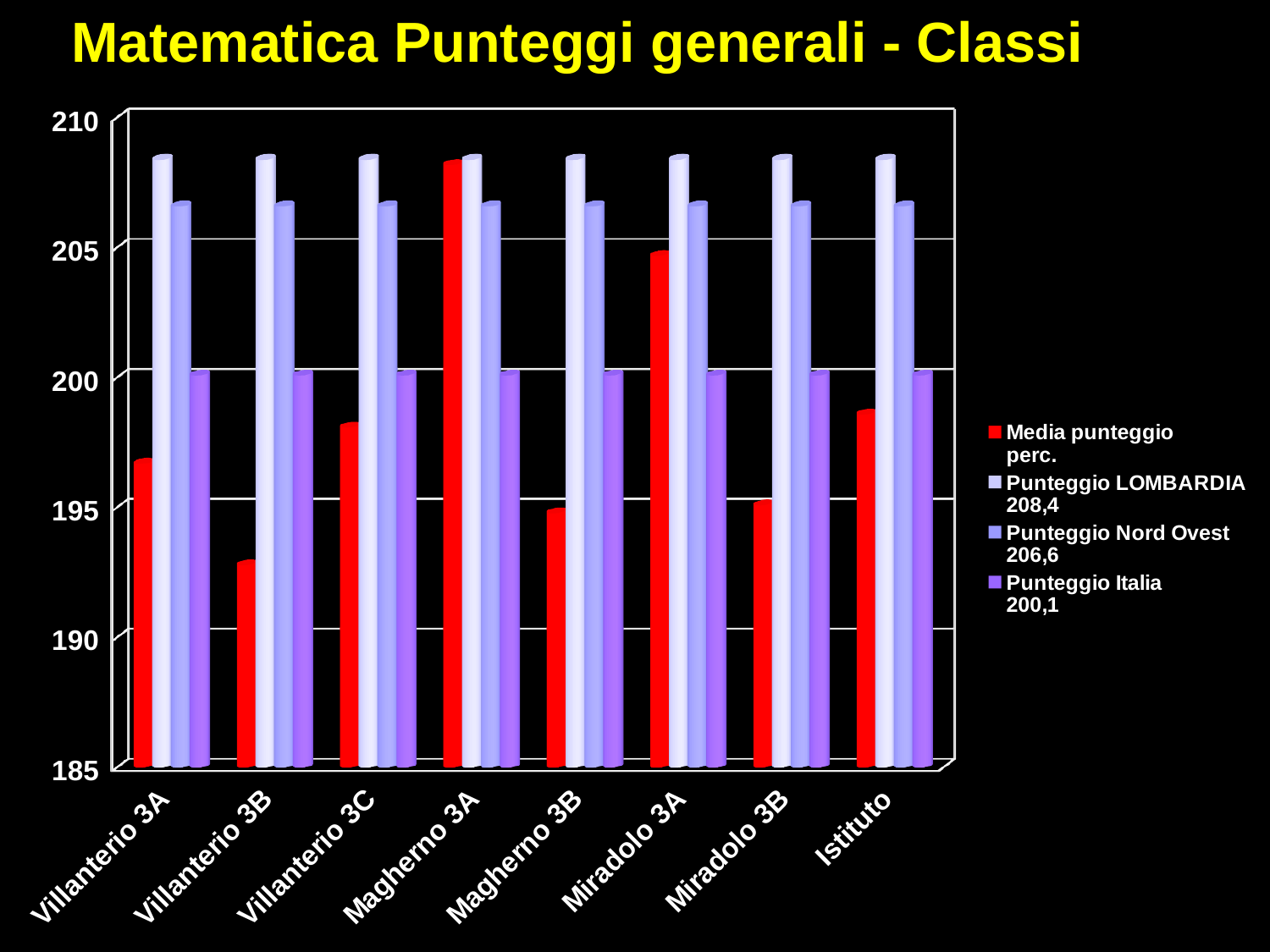
How many categories are shown along the x axis? 8 Is the Media punteggio perc. for Villanterio 3B greater or less than 195? less What is the difference between the Punteggio LOMBARDIA and the Punteggio Italia values shown in the legend? 8,3 Which has a higher Media punteggio perc., Villanterio 3A or Villanterio 3B? Villanterio 3A What kind of chart is shown on the slide? bar chart How many series does the legend list? 4 What is the Punteggio Italia value given in the legend? 200,1 Which class has the lowest Media punteggio perc.? Villanterio 3B Is the Media punteggio perc. for Magherno 3A greater or less than 205? greater What is the title of the chart? Matematica Punteggi generali - Classi What is the Punteggio LOMBARDIA value given in the legend? 208,4 Which class has the highest Media punteggio perc.? Magherno 3A